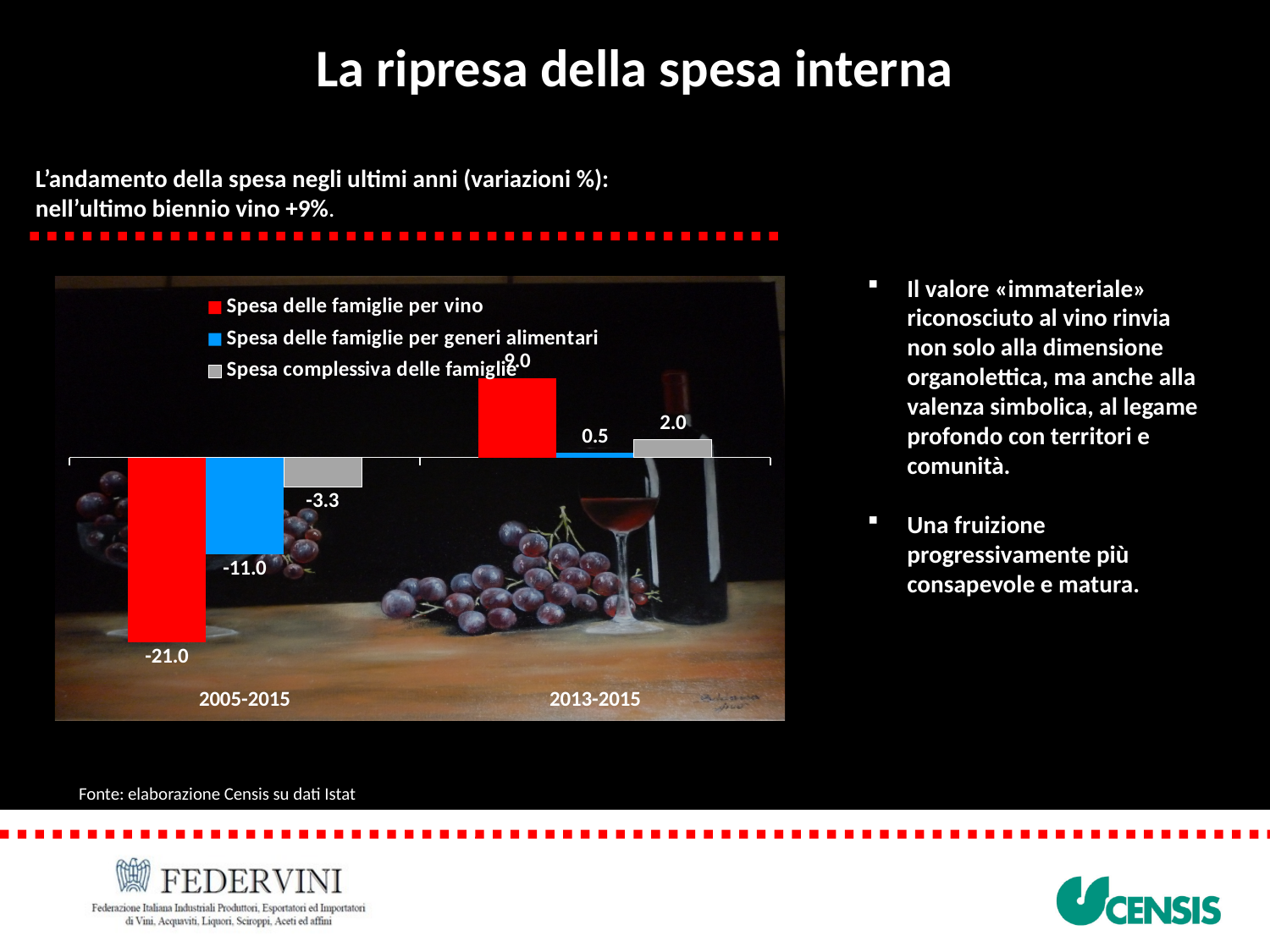
What is the value for 'Spesa delle famiglie per generi alimentari' in the 2005-2015 period? -11.0 What is the difference between the 'Spesa delle famiglie per vino' value and the 'Spesa delle famiglie per generi alimentari' value in the 2005-2015 period? 10.0 Which series has the lowest value in the 2005-2015 period? Spesa delle famiglie per vino What is the value for 'Spesa delle famiglie per generi alimentari' in the 2013-2015 period? 0.5 What is the value for 'Spesa delle famiglie per vino' in the 2005-2015 period? -21.0 How many series does the chart legend list? 3 Which colour represents 'Spesa delle famiglie per vino' in the chart? red What is the value for 'Spesa complessiva delle famiglie' in the 2013-2015 period? 2.0 What type of chart is shown on the slide? bar chart How many period categories are shown on the x axis of the chart? 2 What is the value for 'Spesa complessiva delle famiglie' in the 2005-2015 period? -3.3 Which series has the highest value in the 2013-2015 period? Spesa delle famiglie per vino